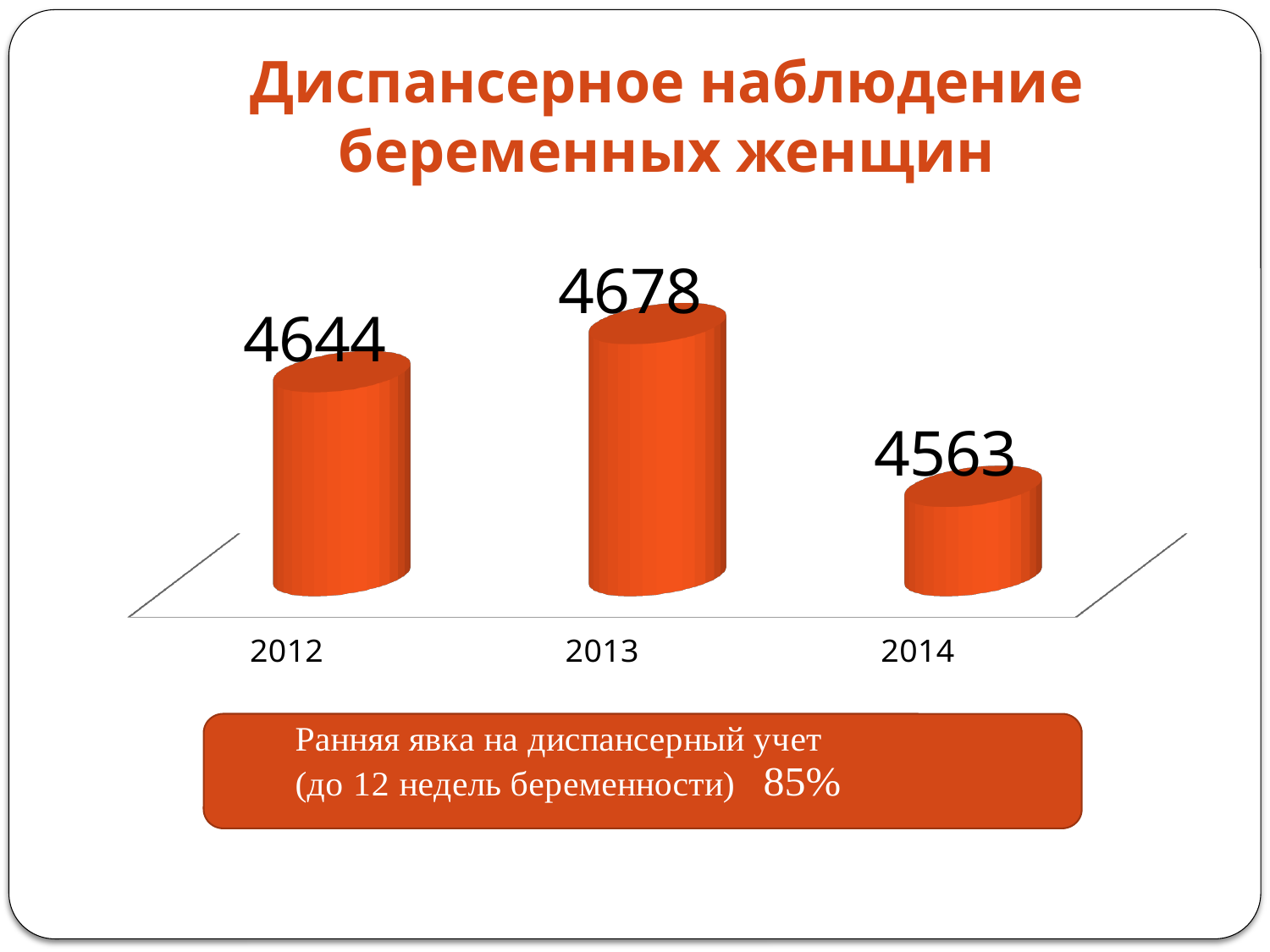
What is the difference between the values for 2013 and 2014? 115 What is the value for 2014? 4563 How many years are shown on the chart? 3 Does the value rise or fall from 2013 to 2014? fall What is the difference between the values for 2012 and 2014? 81 What is the difference between the values for 2013 and 2012? 34 Which is larger, the value for 2012 or the value for 2014? 2012 Which year has the highest value? 2013 Which year has the lowest value? 2014 What is the value for 2013? 4678 What is the value for 2012? 4644 What kind of chart is shown on the slide? bar chart